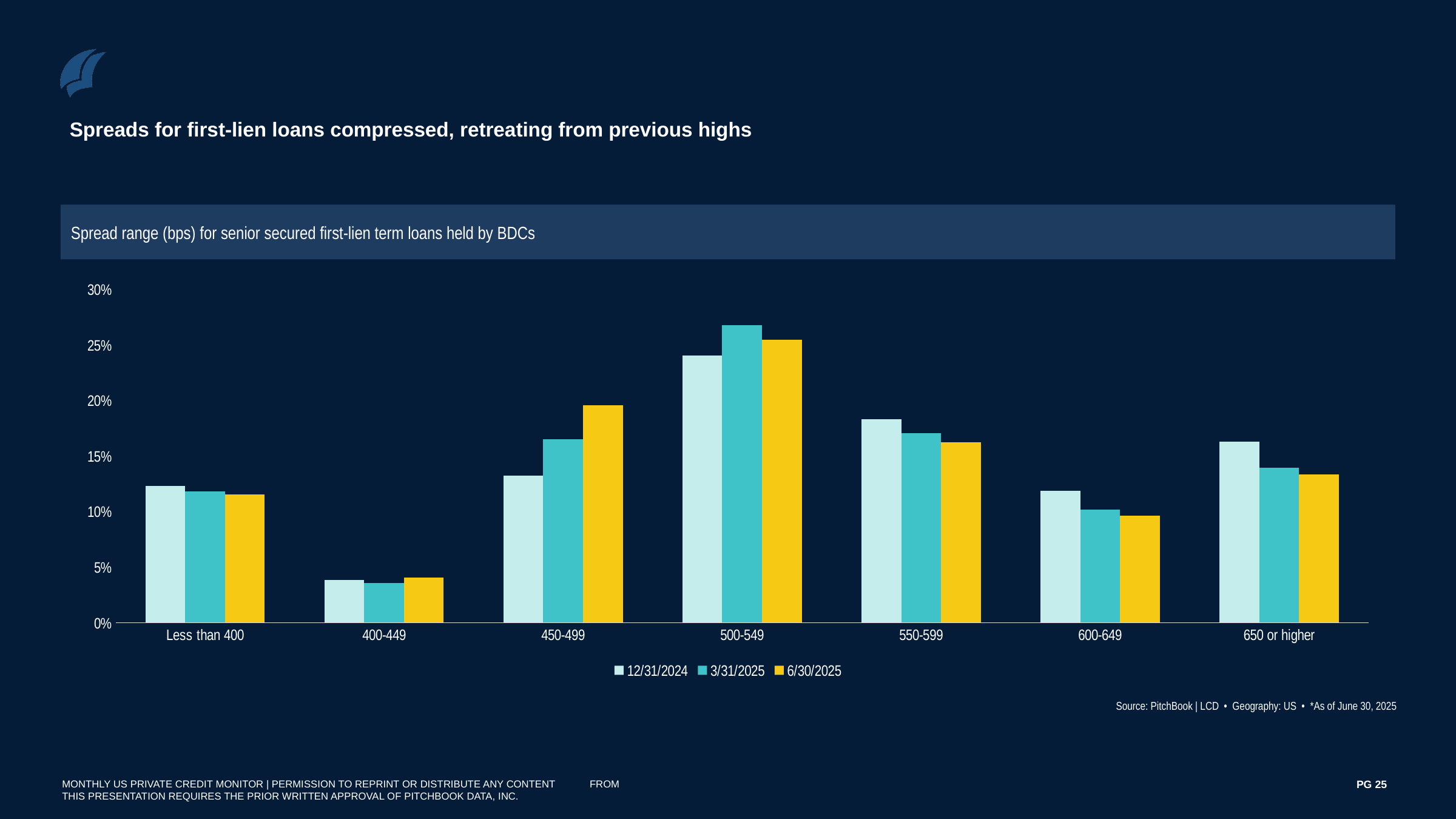
Is the 3/31/2025 value for 400-449 greater or less than 5%? less Which spread range has the lowest value for the 6/30/2025 series? 400-449 Which colour represents the 6/30/2025 series in the legend? Yellow How many spread range categories are shown on the x axis? 7 Which spread range has the highest value for the 3/31/2025 series? 500-549 For the 450-499 spread range, which is larger: the 12/31/2024 value or the 6/30/2025 value? 6/30/2025 What kind of chart is shown on the slide? Bar chart How many series does the legend list? 3 Is the 12/31/2024 value for 500-549 greater or less than 20%? greater Is the 6/30/2025 value for 450-499 greater or less than 15%? greater For the 650 or higher spread range, which is larger: the 12/31/2024 value or the 3/31/2025 value? 12/31/2024 What is the title of the chart? Spread range (bps) for senior secured first-lien term loans held by BDCs